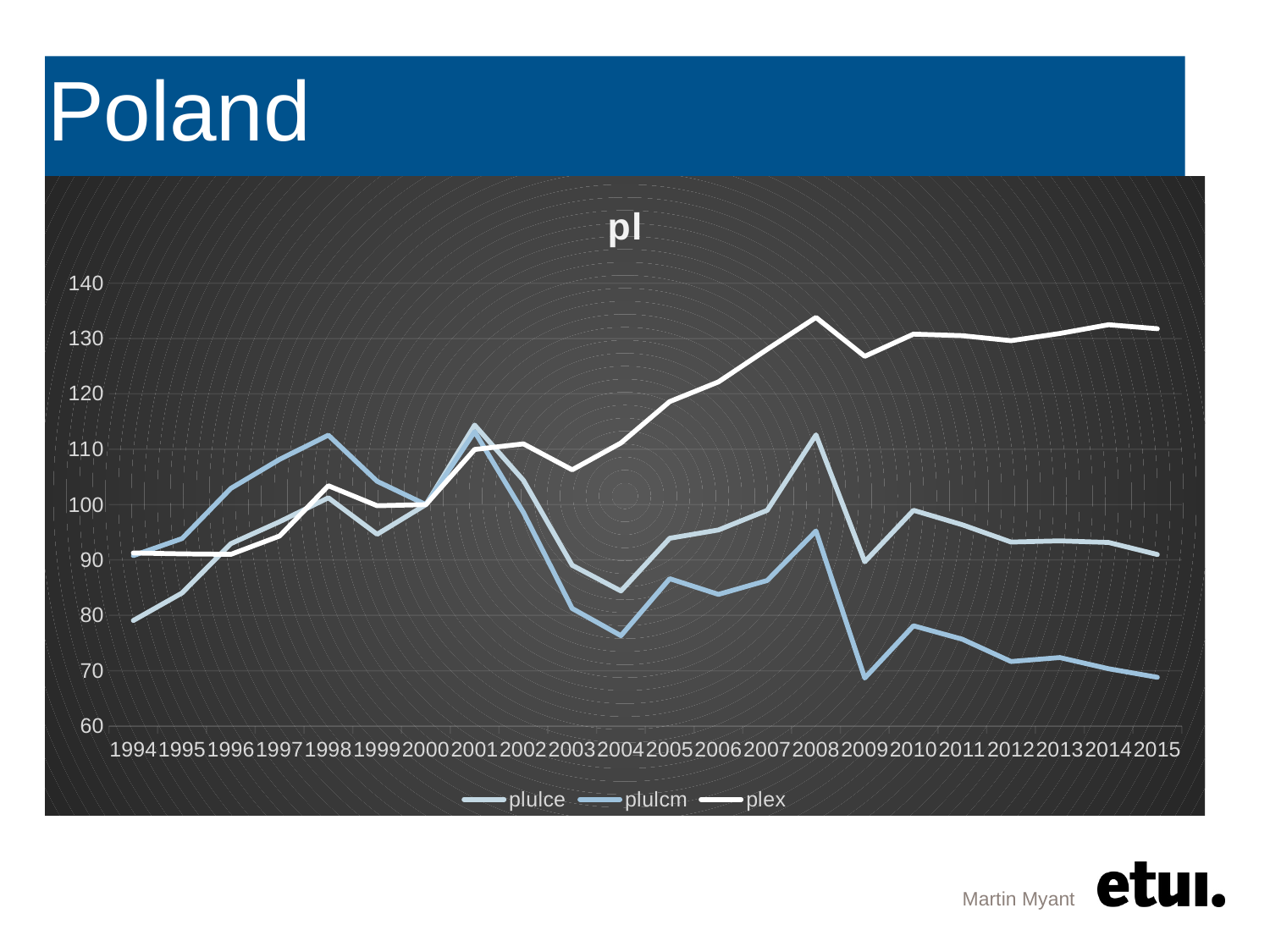
Does the plex series rise or fall from 2004 to 2008? rise Which series has the lowest value in 2015? plulcm In 2015, which is larger: plex or plulcm? plex Is the value for plulcm in 2009 greater or less than 80? less How many series does the legend list? 3 Is the value for plex in 2008 greater or less than 130? greater What are the names of the three series in the legend? plulce, plulcm, plex Is the value for plex in 1994 greater or less than 100? less What is the title of the chart? pl What kind of chart is shown on the slide? line chart How many years are plotted along the x axis? 22